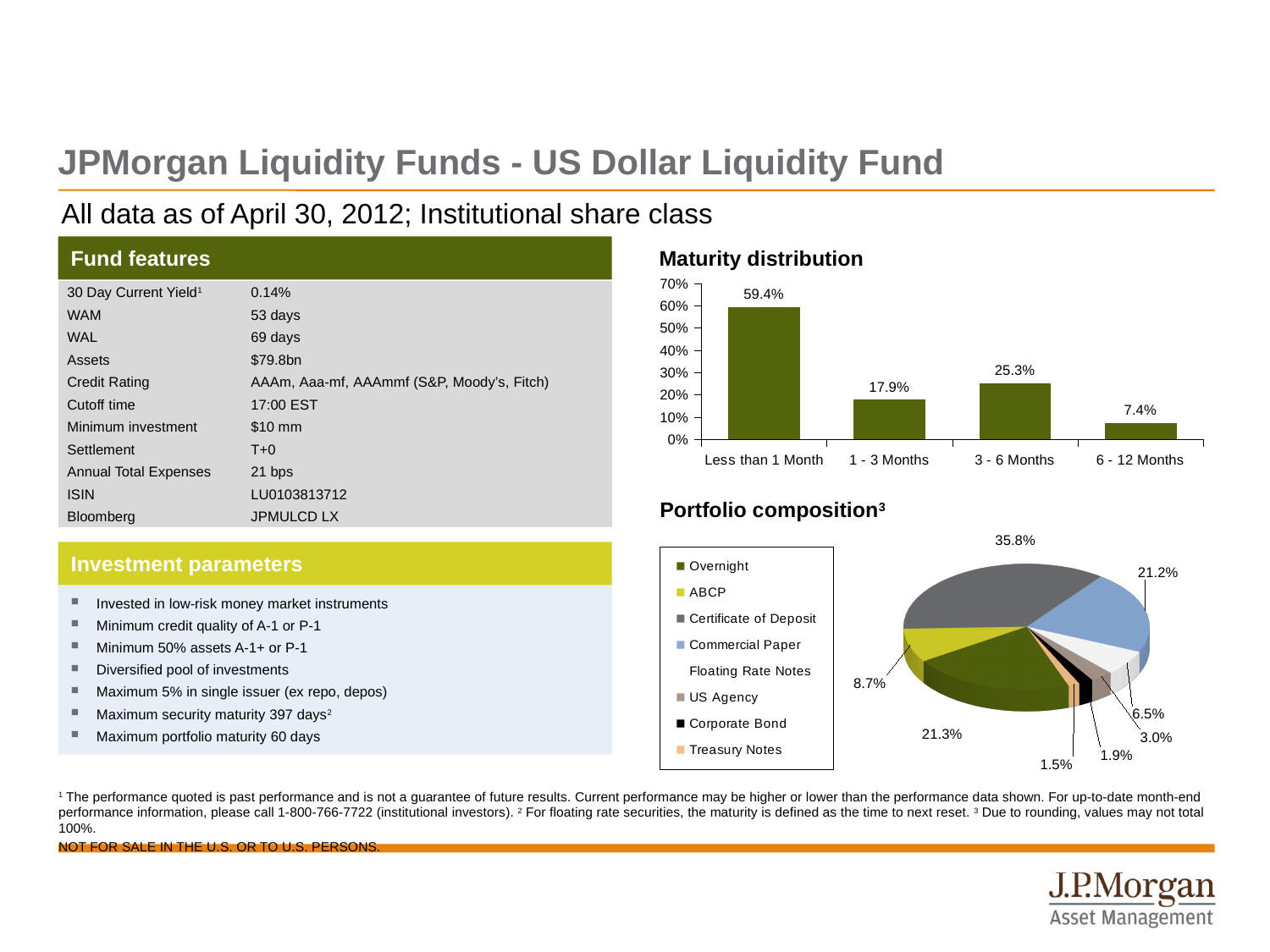
What kind of chart is the Portfolio composition chart? Pie chart In the Maturity distribution chart, which is larger, 1 - 3 Months or 3 - 6 Months? 3 - 6 Months In the Portfolio composition chart, how many entries does the legend list? 8 In the Maturity distribution chart, which category has the highest value? Less than 1 Month In the Portfolio composition chart, what is the value of the largest slice? 35.8% In the Maturity distribution chart, which category has the lowest value? 6 - 12 Months In the Maturity distribution chart, what is the value for Less than 1 Month? 59.4% In the Maturity distribution chart, what is the difference between the values for Less than 1 Month and 1 - 3 Months? 41.5% In the Maturity distribution chart, what is the value for 3 - 6 Months? 25.3% In the Maturity distribution chart, how many maturity categories are shown? 4 What kind of chart is the Maturity distribution chart? Bar chart In the Maturity distribution chart, what is the value for 6 - 12 Months? 7.4%